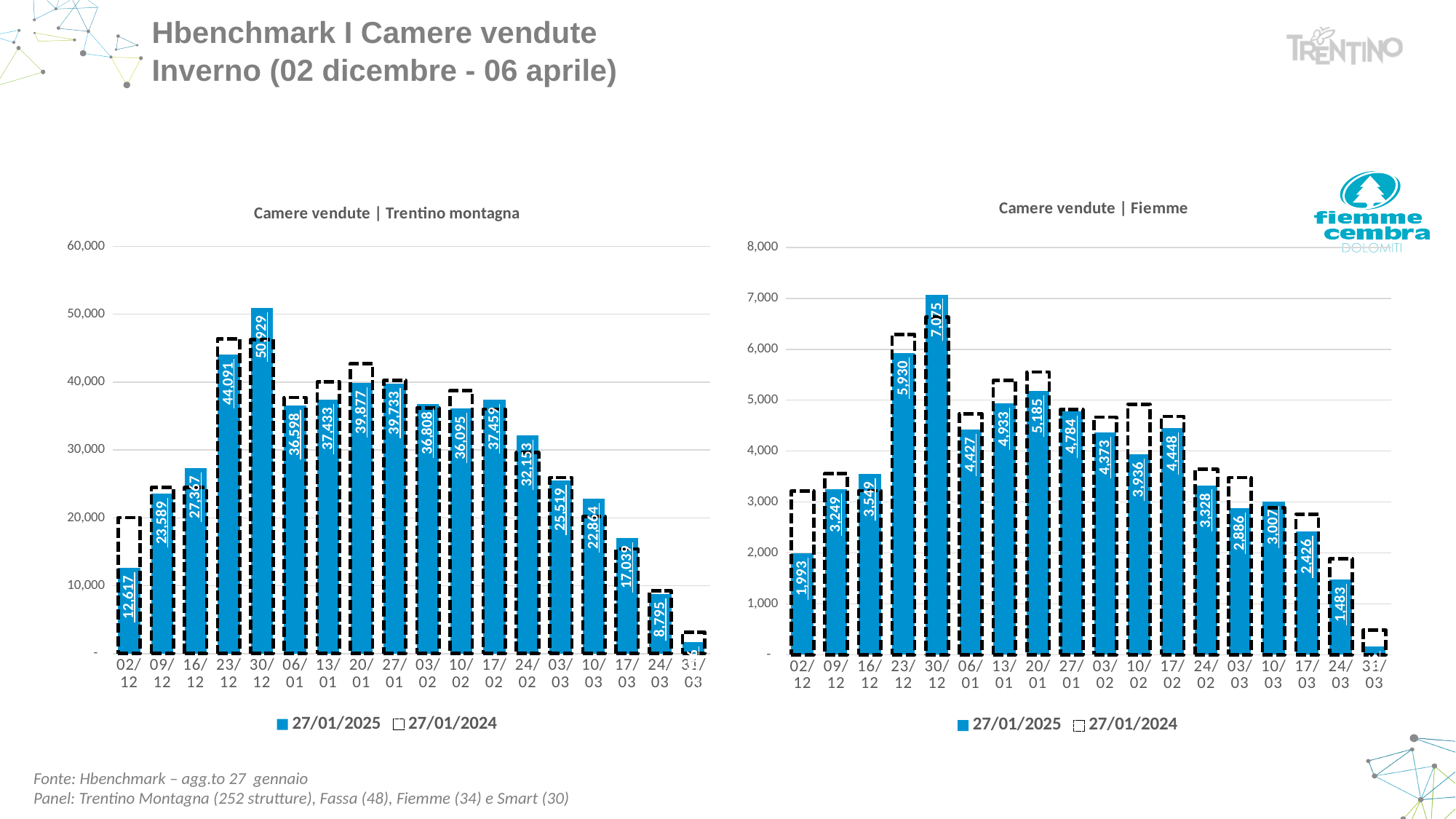
How many weeks are shown on the x axis of the 'Camere vendute | Fiemme' chart? 18 In the 'Camere vendute | Fiemme' chart, what is the 27/01/2025 value for 20/01? 5,185 In the 'Camere vendute | Fiemme' chart, which week has the lowest 27/01/2025 value? 31/03 In the 'Camere vendute | Trentino montagna' chart, which is larger for the 27/01/2025 series: 20/01 or 27/01? 20/01 How many series does the legend of the 'Camere vendute | Trentino montagna' chart list? 2 In the 'Camere vendute | Fiemme' chart, what is the difference between the 27/01/2025 values for 30/12 and 23/12? 1,145 In the 'Camere vendute | Trentino montagna' chart, is the 27/01/2024 value for 23/12 greater or less than 40,000? greater What kind of chart is 'Camere vendute | Fiemme'? Bar chart In the 'Camere vendute | Trentino montagna' chart, do the 27/01/2025 values rise or fall from 24/02 to 24/03? Fall In the 'Camere vendute | Trentino montagna' chart, which week has the highest 27/01/2025 value? 30/12 In the 'Camere vendute | Fiemme' chart, is the 27/01/2024 value for 02/12 greater or less than 3,000? greater In the 'Camere vendute | Trentino montagna' chart, what is the 27/01/2025 value for 30/12? 50,929